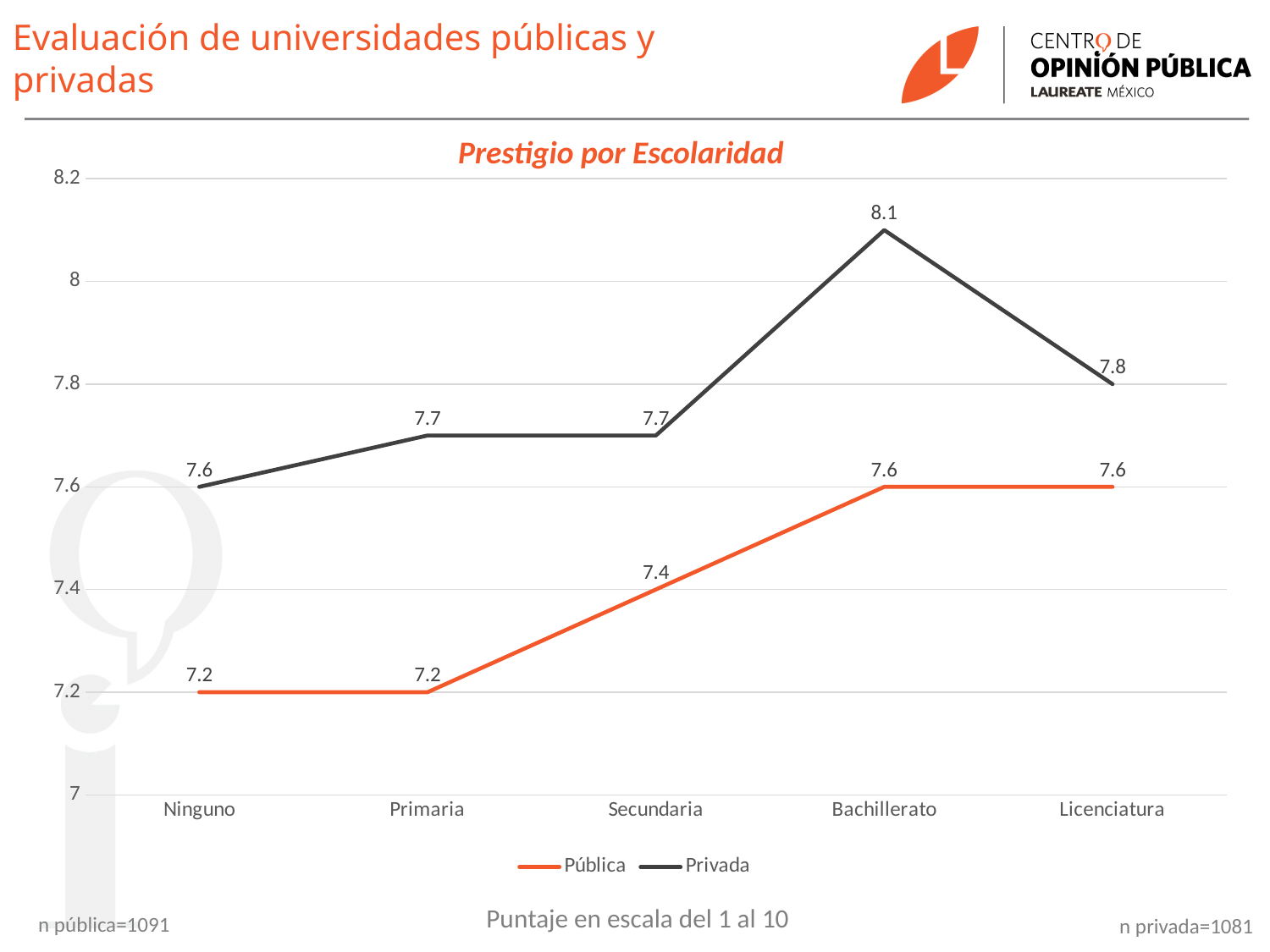
What is the title of the chart? Prestigio por Escolaridad What is the difference between Privada and Pública at Ninguno? 0.4 Which education level has the lowest value for the Privada series? Ninguno What is the difference between Privada and Pública at Bachillerato? 0.5 How many education levels are shown on the x axis? 5 What is the value for Pública at Secundaria? 7.4 Which is larger at Licenciatura, Pública or Privada? Privada Which education level has the highest value for the Privada series? Bachillerato What kind of chart is shown on the slide? Line chart What is the value for Privada at Bachillerato? 8.1 How many series does the legend list? 2 What is the value for Privada at Licenciatura? 7.8